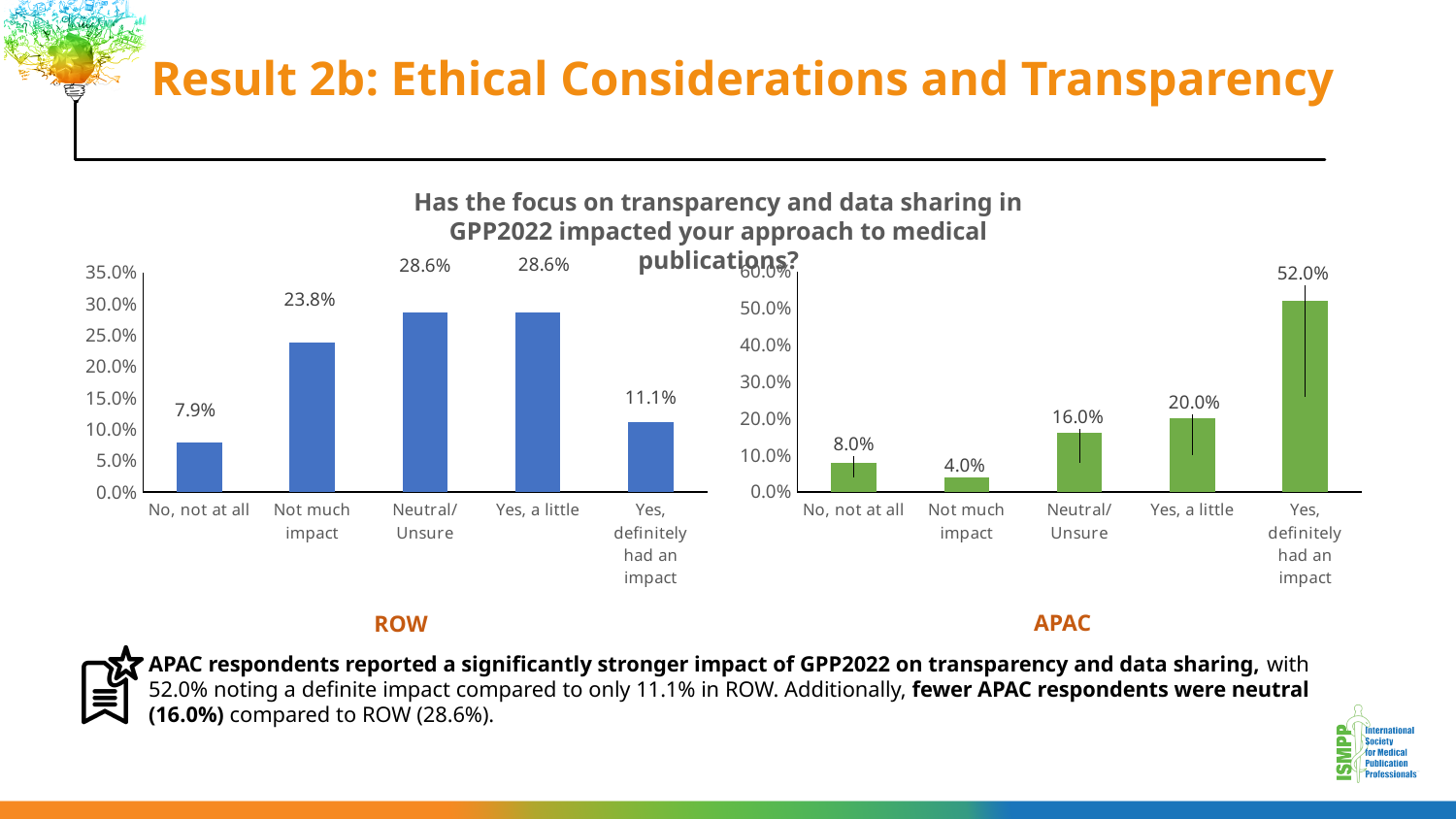
In the APAC chart, which category has the highest value? Yes, definitely had an impact What colour are the bars in the APAC chart? Green In the APAC chart, what is the difference between "Yes, definitely had an impact" and "Neutral/Unsure"? 36.0% In the ROW chart, what is the value for "Yes, definitely had an impact"? 11.1% In the ROW chart, what is the value for "Not much impact"? 23.8% How many categories are shown in the APAC chart? 5 In the ROW chart, what is the difference between "Neutral/Unsure" and "No, not at all"? 20.7% Which is larger: the "Neutral/Unsure" value in the ROW chart or in the APAC chart? ROW What type of chart is the ROW chart? Bar chart In the APAC chart, what is the value for "Yes, definitely had an impact"? 52.0% In the ROW chart, which category has the lowest value? No, not at all In the APAC chart, which category has the lowest value? Not much impact